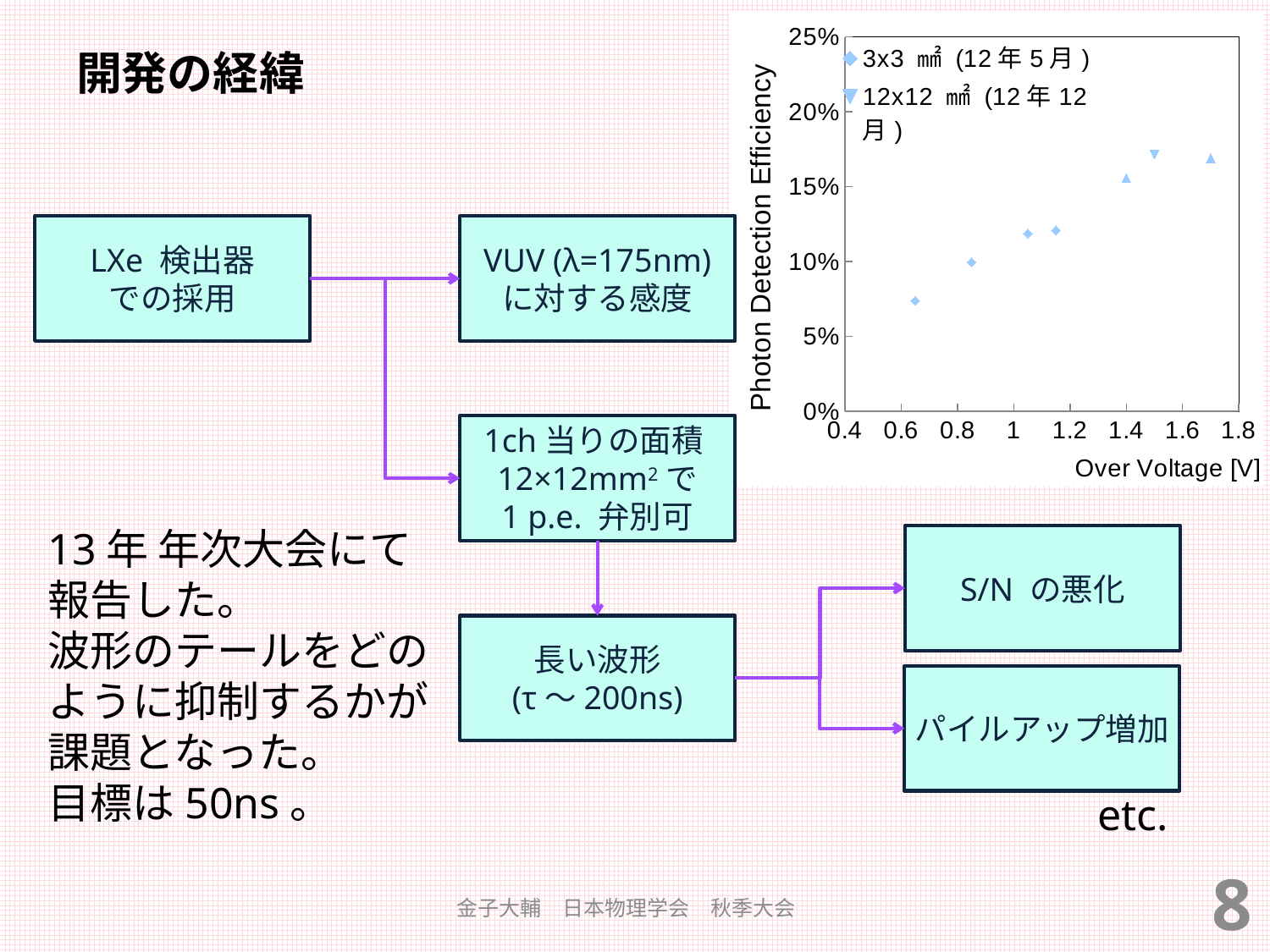
How many data points are plotted for the 3x3 mm² series? 4 What is the label of the y axis of the chart? Photon Detection Efficiency Does the photon detection efficiency rise or fall as over voltage increases? rise What is the label of the x axis of the chart? Over Voltage [V] Which series reaches the higher photon detection efficiency, 3x3 mm² or 12x12 mm²? 12x12 mm² Is the photon detection efficiency of the 3x3 mm² point at about 1.15 V greater or less than 15%? less How many series does the chart legend list? 2 What kind of chart is shown on the slide? scatter chart Is the photon detection efficiency of the 12x12 mm² point at 1.4 V greater or less than 15%? greater Is the photon detection efficiency of the 12x12 mm² point at 1.5 V greater or less than 20%? less